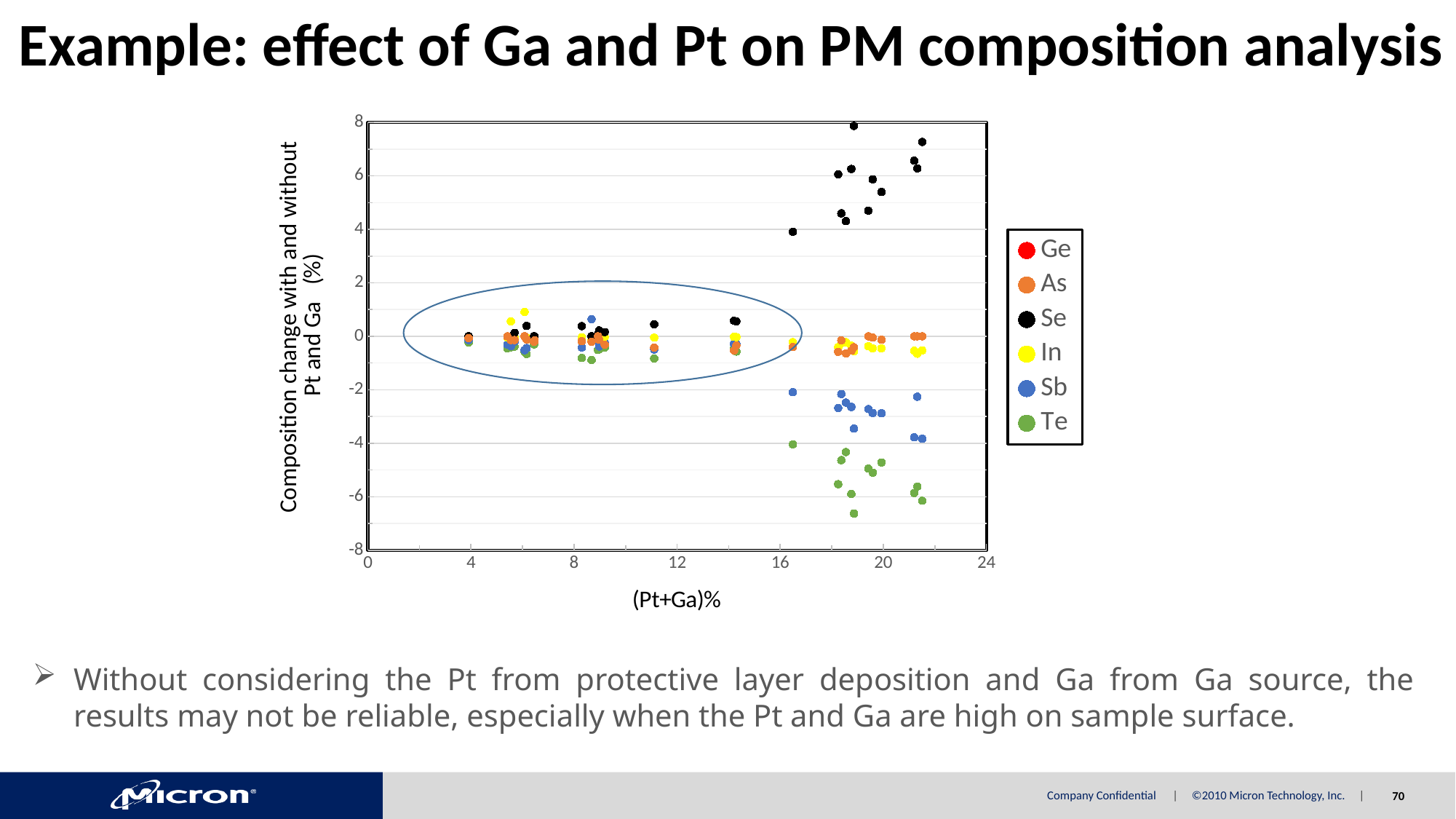
Is the lowest Te value greater or less than -6? less What kind of chart is shown on the slide? scatter chart Which series are listed in the legend? Ge, As, Se, In, Sb, Te What is the label of the x axis? (Pt+Ga)% Which series has the highest composition change values at high (Pt+Ga)%? Se Do the Te values rise or fall as (Pt+Ga)% increases? fall At (Pt+Ga)% around 20, which series has larger values, Se or Sb? Se Which series has the lowest composition change values at high (Pt+Ga)%? Te How many series does the legend list? 6 Is the highest Se value greater or less than 6? greater Do the Se values rise or fall as (Pt+Ga)% increases? rise